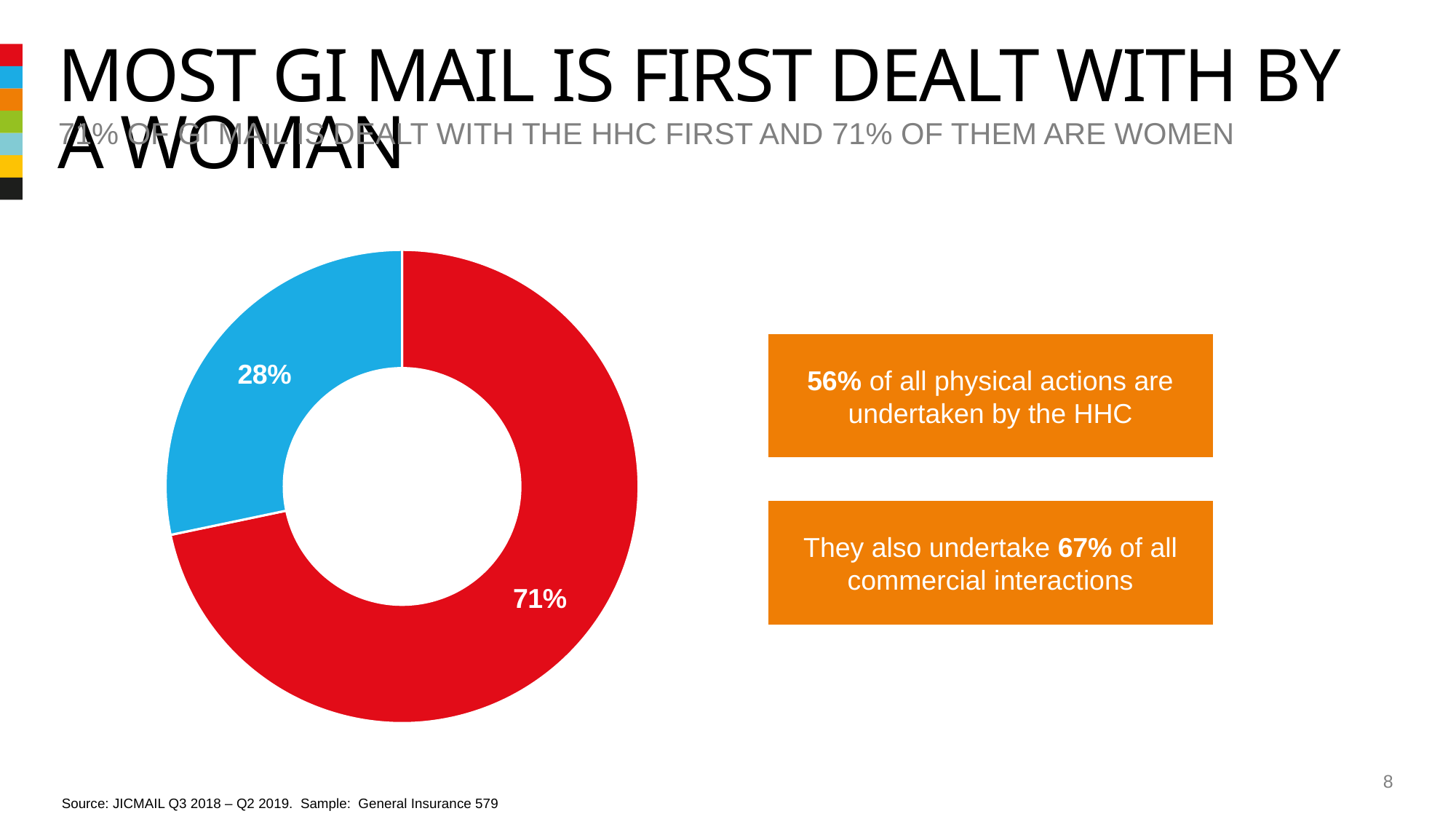
Which slice of the pie chart is the largest? The red slice (71%) What value is shown on the blue slice of the pie chart? 28% What kind of chart is shown on the slide? Pie chart (donut) What is the difference between the red slice and the blue slice in the pie chart? 43 percentage points Does the pie chart have a legend? No Which slice of the pie chart is the smallest? The blue slice (28%) What share of the pie does the blue slice represent? 28% Is the value of the red slice greater or less than 50%? greater What value is shown on the red slice of the pie chart? 71% Which is larger in the pie chart, the red slice or the blue slice? The red slice How many slices does the pie chart have? 2 What colours are used for the two slices of the pie chart? Red and blue